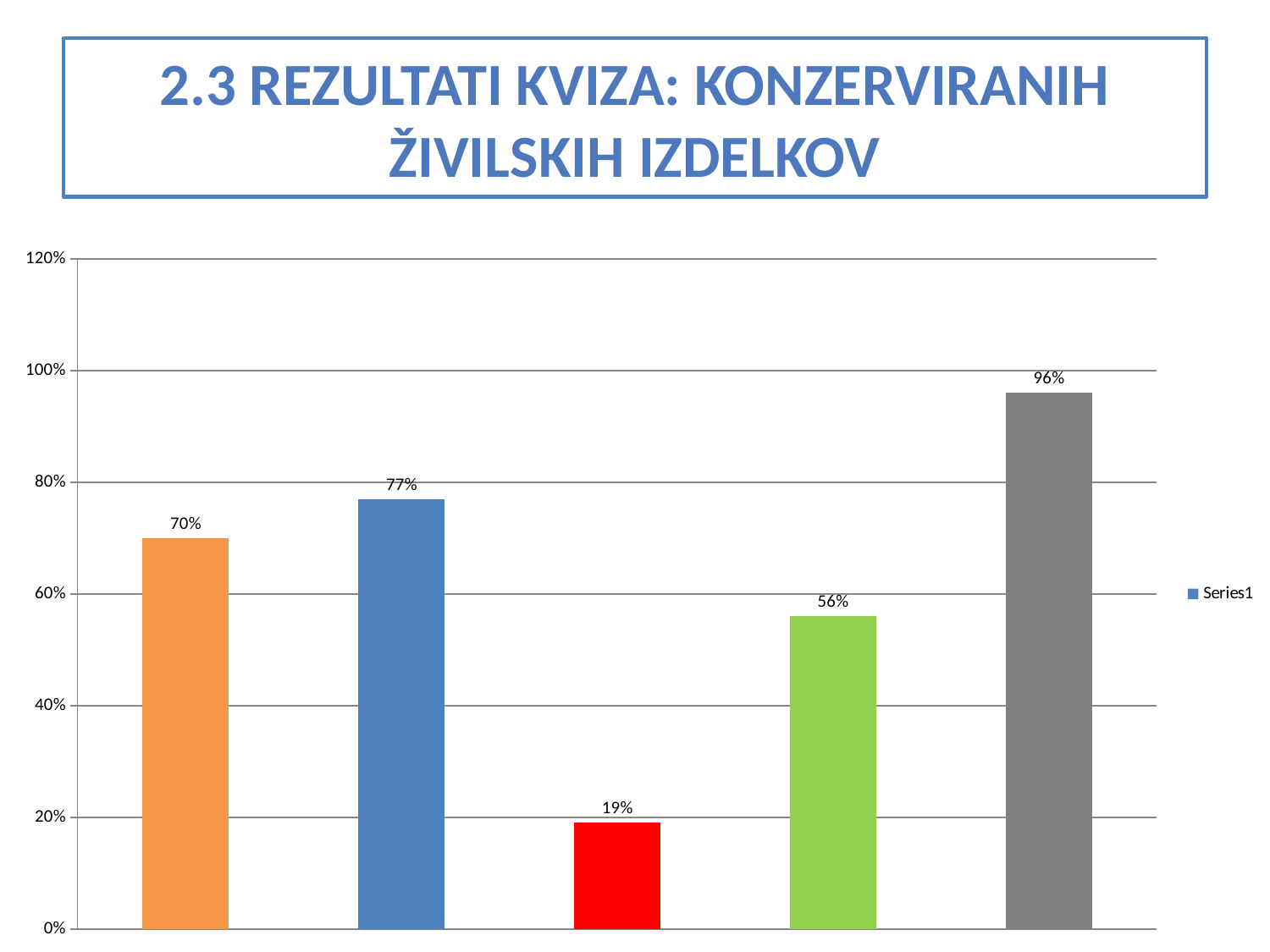
How many bars are plotted in the chart? 5 What is the value of the red bar? 19% What is the value of the green bar? 56% Which bar has the highest value? the grey bar (96%) What is the value of the first (orange) bar from the left? 70% What is the difference between the grey bar and the red bar? 77% What is the value of the grey bar on the far right? 96% What is the name of the series shown in the legend? Series1 How many series does the legend list? 1 What is the value of the second (blue) bar from the left? 77% Which bar has the lowest value? the red bar (19%) What type of chart is shown on the slide? bar chart